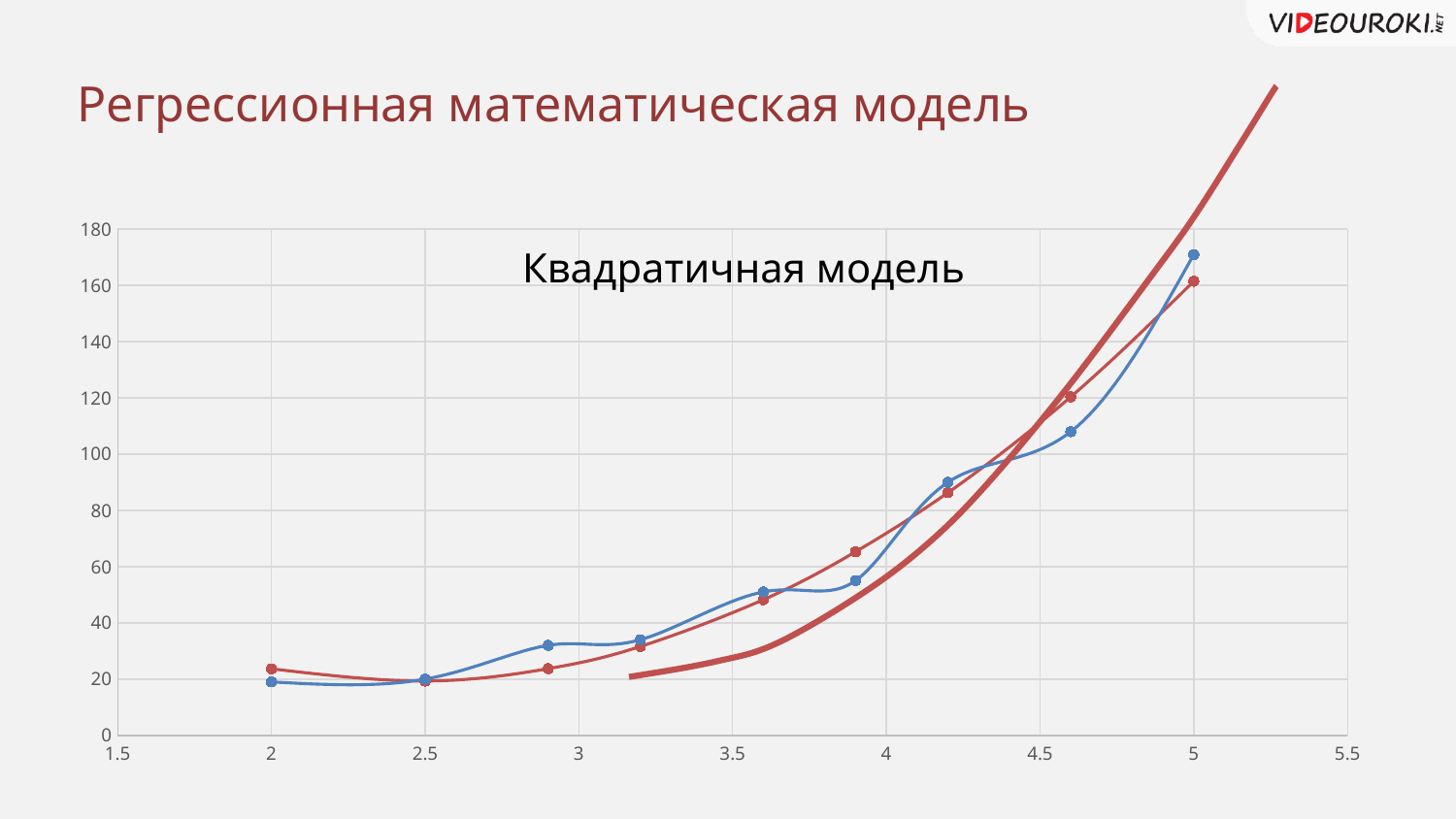
Do the values of the blue series rise or fall as x increases from 2 to 5? rise At x = 5, which series has the larger value, the blue one or the red one with markers? blue Is the value of the red marked series at x = 4.6 greater or less than 100? greater What is the highest value shown on the vertical axis of the chart? 180 At x = 4.6, which series has the larger value, the blue one or the red one with markers? red How many marked data points does the blue series have? 9 Is the value of the blue series at x = 5 greater or less than 160? greater At which x value does the blue series reach its highest point? 5 Is the value of the blue series at x = 3.9 greater or less than 60? less At x = 3.9, which series has the larger value, the blue one or the red one with markers? red What text label is printed inside the plot area of the chart? Квадратичная модель What kind of chart is shown on the slide? line chart